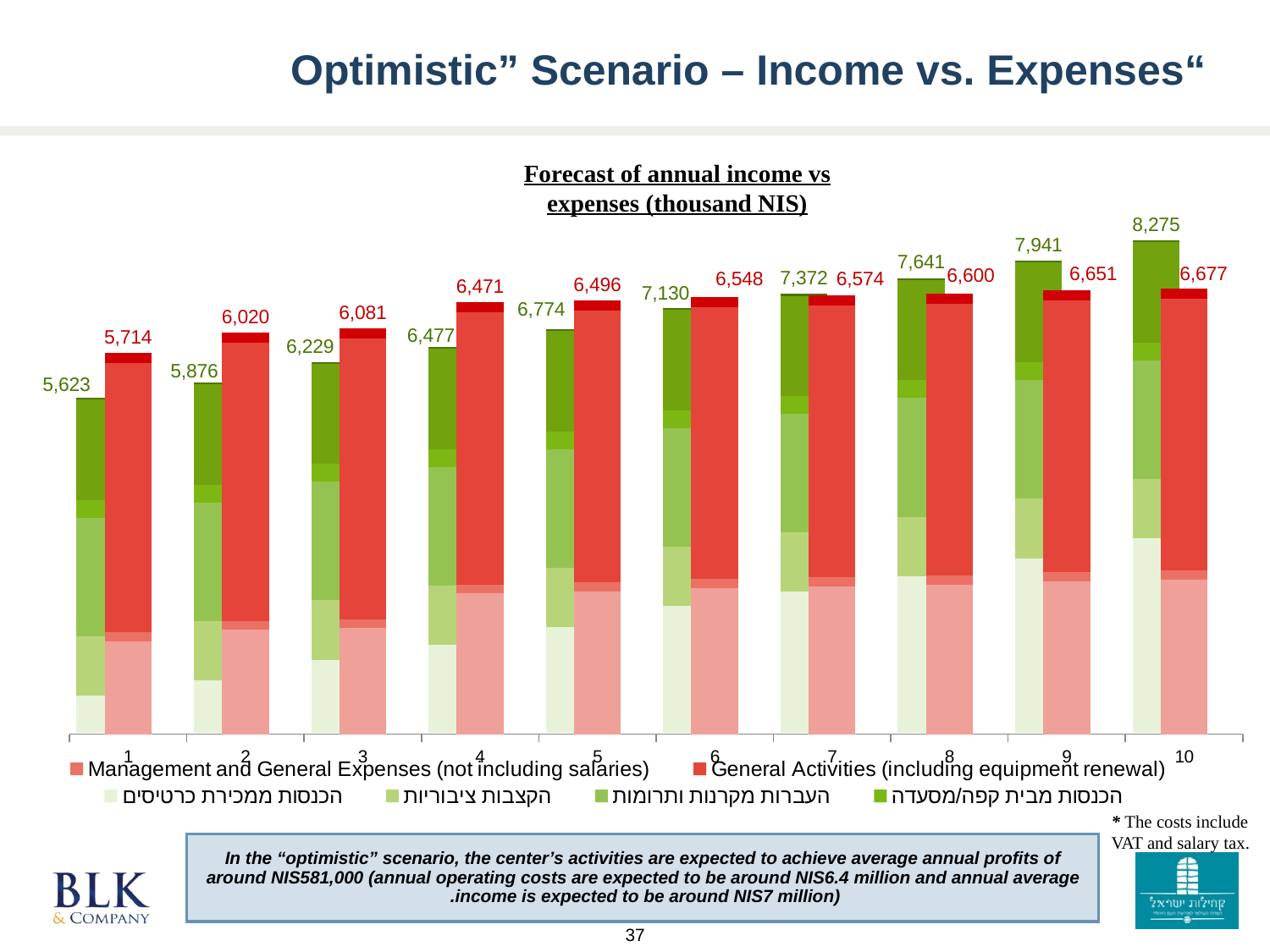
What kind of chart is shown on the slide? Stacked bar chart How many series does the chart's legend list? 6 What is the labelled total of the income (green) bar for year 5? 6,774 In year 1, which is larger: the income total or the expenses total? Expenses total (5,714) In which year is the expenses (red) bar total the lowest? 1 Do the income (green) bar totals rise or fall from year 1 to year 10? Rise How many year categories are shown along the x axis of the chart? 10 In which year is the income (green) bar total the highest? 10 What is the labelled total of the expenses (red) bar for year 10? 6,677 What is the difference between the income total and the expenses total in year 10? 1,598 What is the title of the chart? Forecast of annual income vs expenses (thousand NIS) What is the labelled total of the income (green) bar for year 1? 5,623